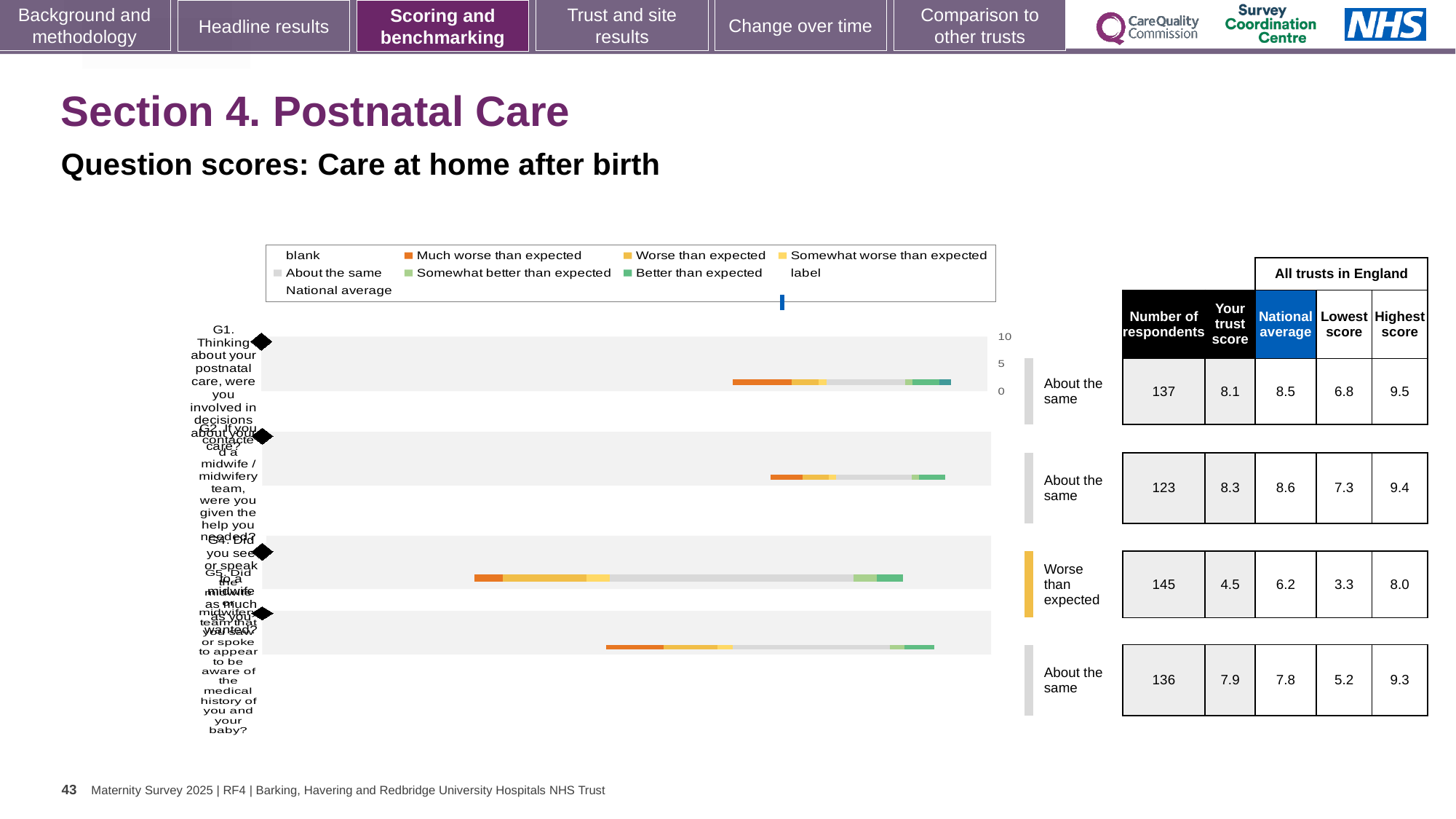
Is the trust score for G1 larger or smaller than its national average? smaller Which row in the table has the highest number of respondents? the third row (145) What is the national average for G2 (given the help you needed when contacting a midwife / midwifery team)? 8.6 What is the difference between the highest score and the lowest score for G1? 2.7 How many question rows (bars) does the chart show? 4 Which row is rated 'Worse than expected'? the third row What is the number of respondents for G1 (involved in decisions about your postnatal care)? 137 Which row has the lowest trust score? the third row (4.5) How many entries does the chart legend list? 9 What colour represents 'Much worse than expected' in the chart legend? orange What kind of chart is shown on the slide? bar chart What is the trust score for G1 (involved in decisions about your postnatal care)? 8.1